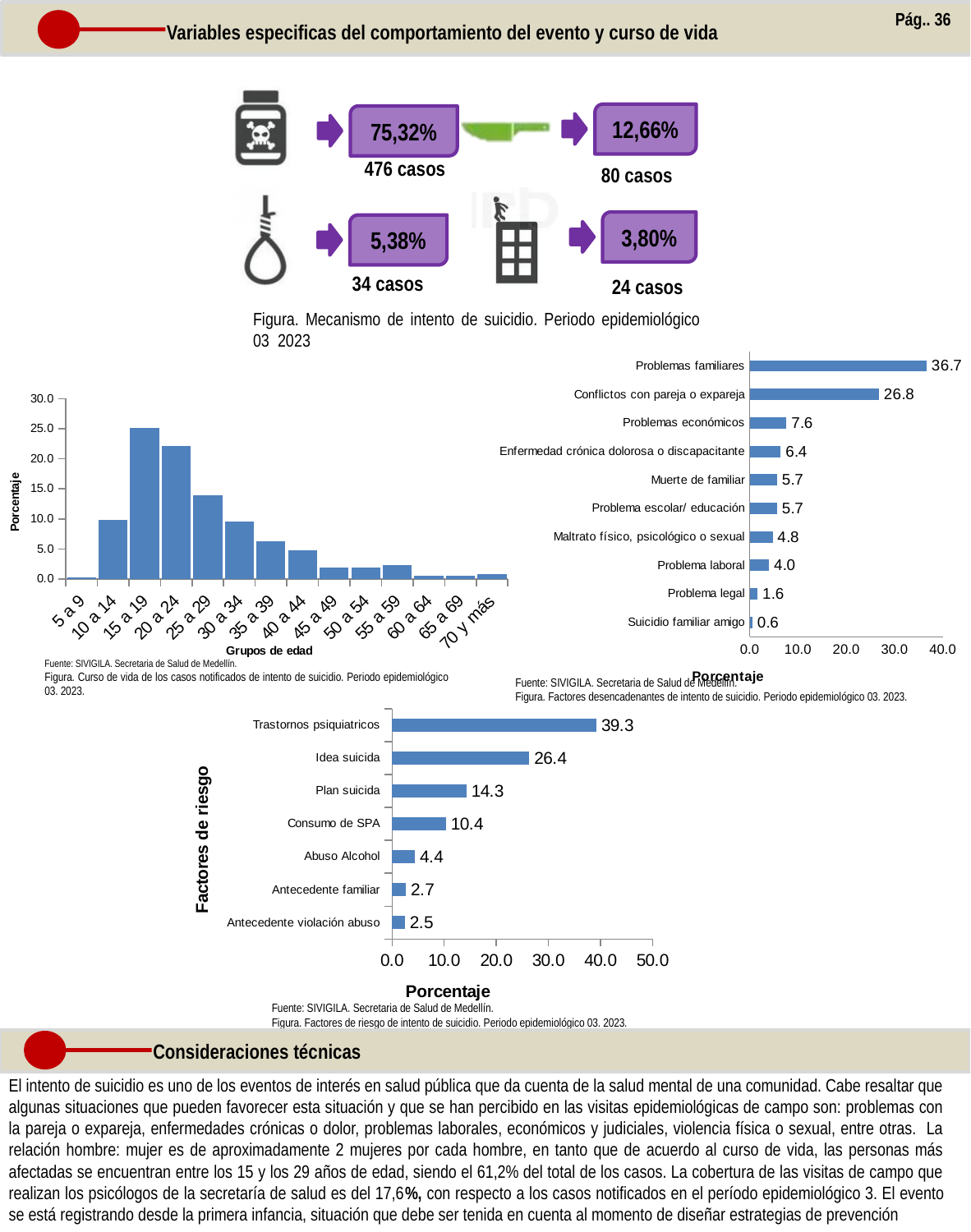
In the 'Factores de riesgo' chart at the bottom, what is the value for Trastornos psiquiatricos? 39.3 In the 'Grupos de edad' chart on the left, is the value for 20 a 24 greater or less than 20.0? greater In the 'Factores desencadenantes' chart on the right, which category has the lowest value? Suicidio familiar amigo In the 'Factores desencadenantes' chart on the right, what is the value for Problema laboral? 4.0 In the 'Factores de riesgo' chart at the bottom, what is the value for Consumo de SPA? 10.4 In the 'Factores desencadenantes' chart on the right, what is the value for Problemas familiares? 36.7 In the 'Factores de riesgo' chart at the bottom, how many categories are shown? 7 In the 'Factores desencadenantes' chart on the right, how many categories are shown? 10 In the 'Grupos de edad' chart on the left, which age group has the highest value? 15 a 19 In the 'Factores de riesgo' chart at the bottom, what is the difference between Idea suicida and Plan suicida? 12.1 In the 'Factores desencadenantes' chart on the right, what is the difference between Problemas familiares and Conflictos con pareja o expareja? 9.9 In the 'Factores de riesgo' chart at the bottom, which is larger: Plan suicida or Abuso Alcohol? Plan suicida